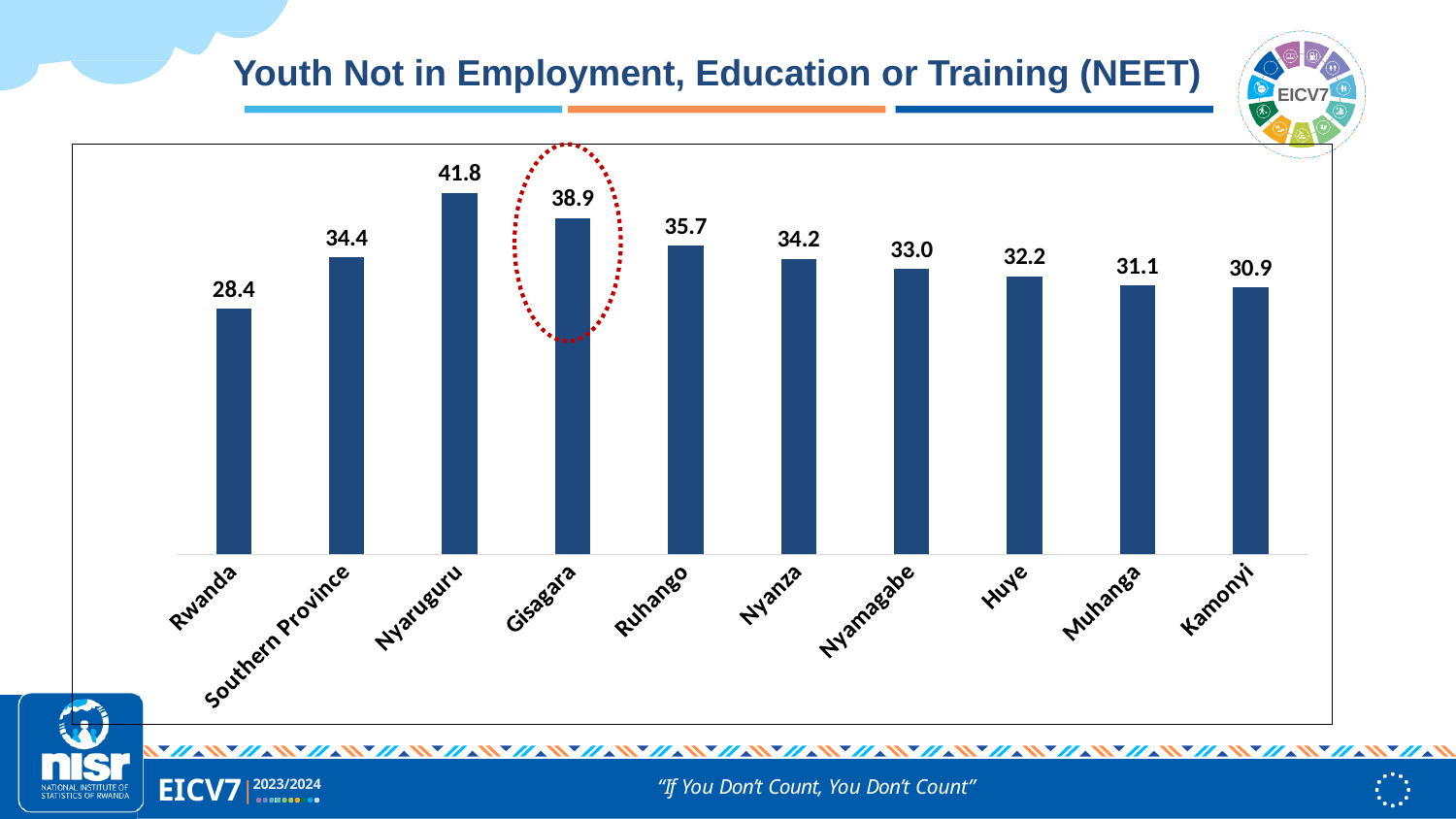
Which bar is highlighted with a red dotted circle? Gisagara What is the NEET value for Nyaruguru? 41.8 What kind of chart is shown on the slide? Bar chart What is the NEET value for Gisagara? 38.9 How many categories are shown on the chart? 10 What is the difference between the NEET values for Gisagara and Southern Province? 4.5 Which has a higher NEET value, Ruhango or Huye? Ruhango Which category has the highest NEET value? Nyaruguru What is the difference between the NEET values for Nyaruguru and Rwanda? 13.4 What is the NEET value for Rwanda? 28.4 Which category has the lowest NEET value? Rwanda What is the NEET value for Kamonyi? 30.9